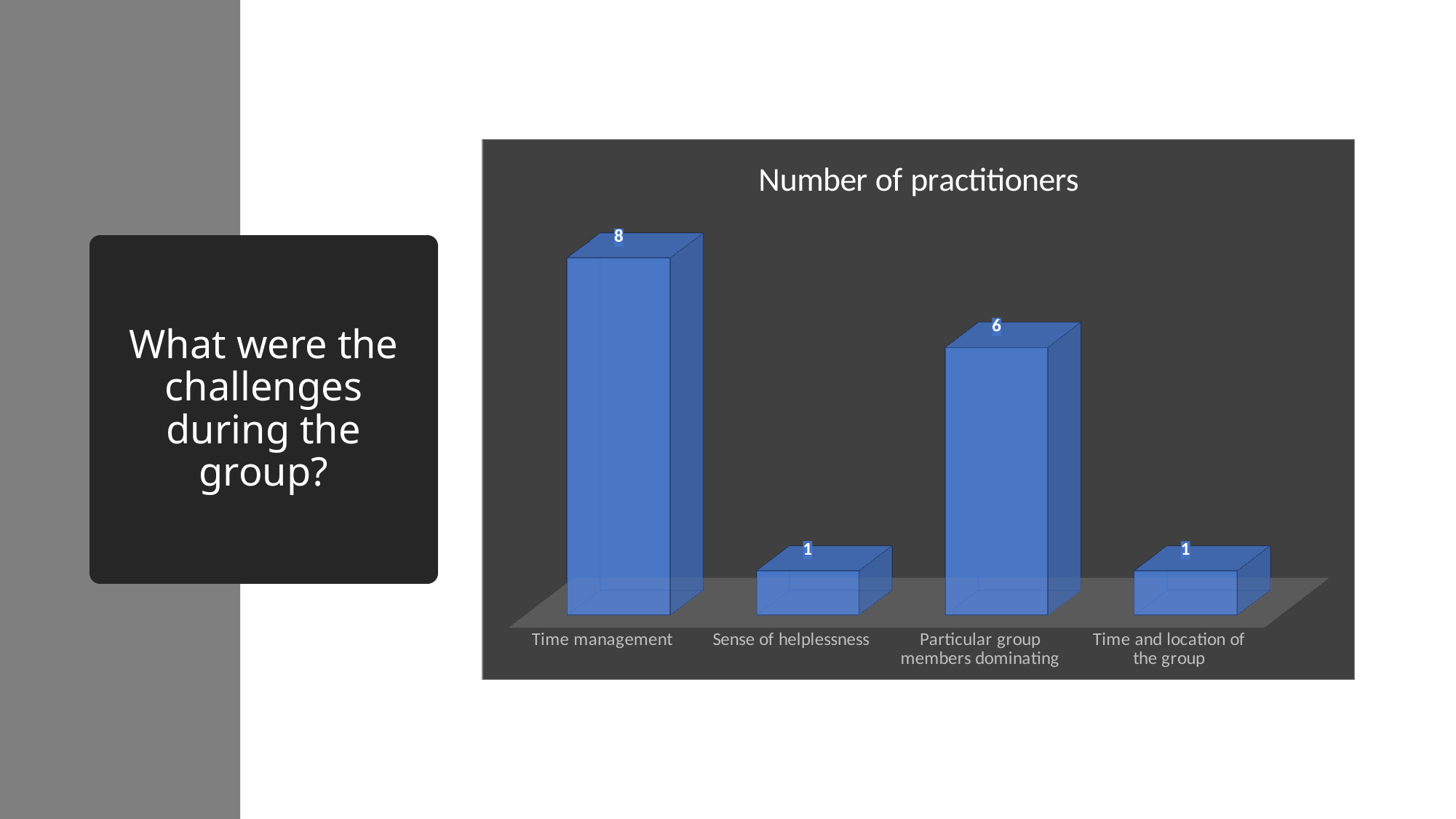
What kind of chart is shown on the slide? Bar chart What is the value for Sense of helplessness? 1 What is the difference between the values for Time management and Particular group members dominating? 2 Which category has the highest value? Time management What is the value for Particular group members dominating? 6 What is the difference between the values for Time management and Sense of helplessness? 7 What is the title of the chart? Number of practitioners What is the value for Time and location of the group? 1 What is the value for Time management? 8 What is the total of all four values in the chart? 16 Which is larger, the value for Particular group members dominating or the value for Time and location of the group? Particular group members dominating How many categories are shown in the chart? 4